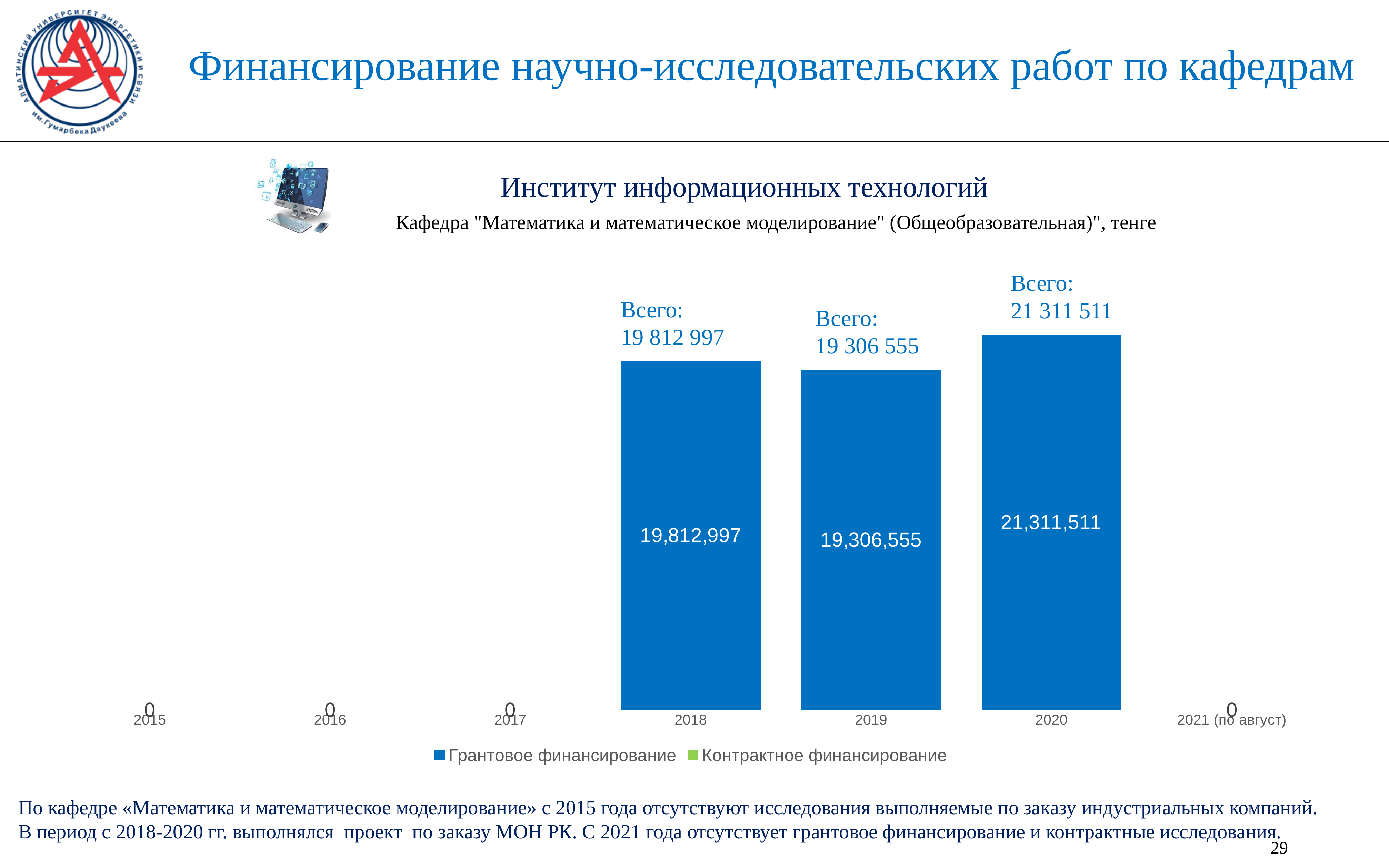
What is the grant funding value for 2018? 19,812,997 What is the grant funding value for 2020? 21,311,511 What is the total (Всего) shown above the 2020 bar? 21 311 511 What is the value shown for 2015? 0 What is the difference between the 2020 and 2019 grant funding values? 2,004,956 What kind of chart is shown on the slide? Bar chart How many year categories are shown on the x axis? 7 Which is larger, the grant funding for 2018 or for 2019? 2018 What is the grant funding value for 2019? 19,306,555 How many series does the legend list? 2 Which year has the highest grant funding? 2020 Which of the years with non-zero funding has the lowest value? 2019